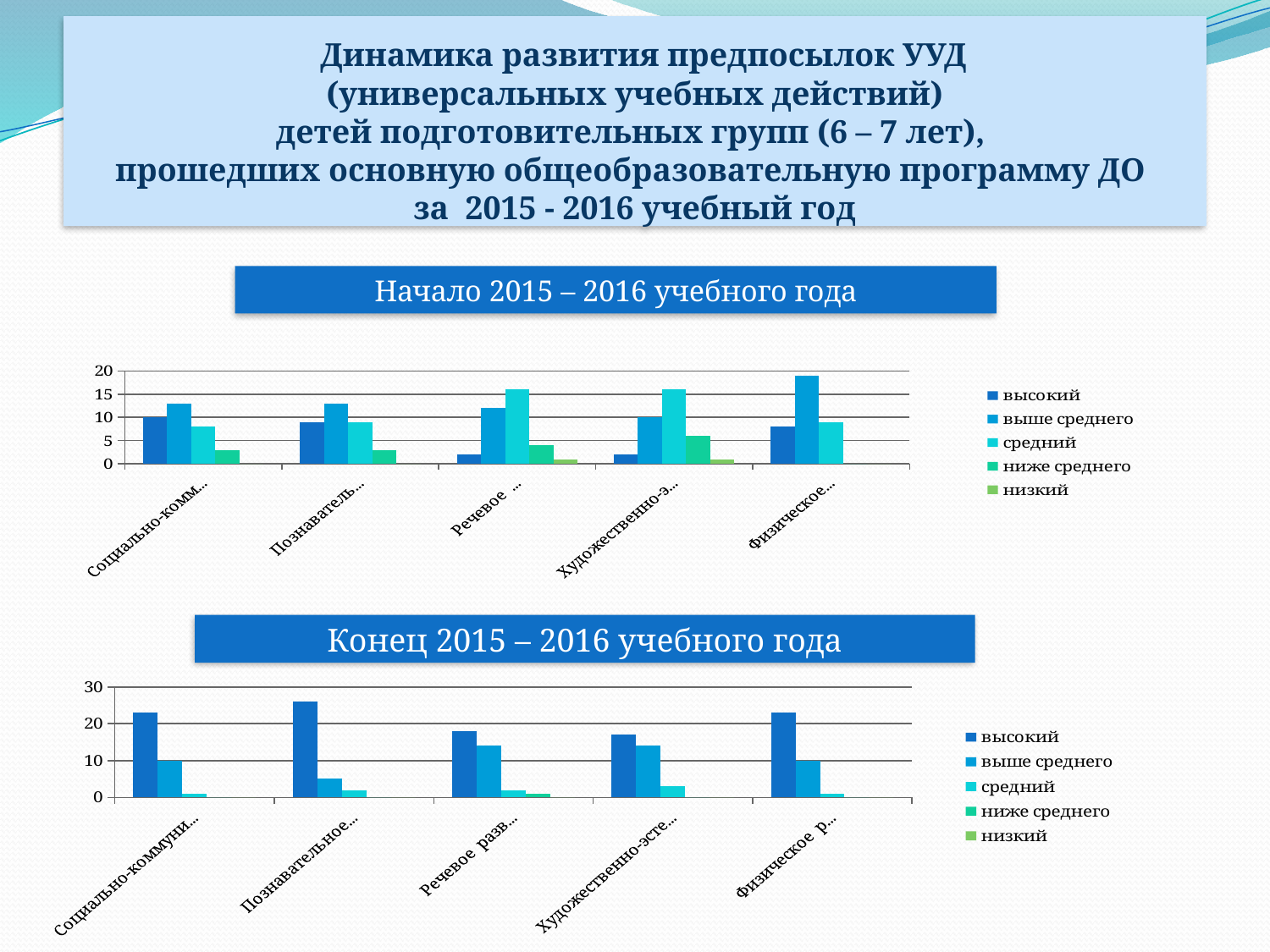
In the chart "Начало 2015 – 2016 учебного года", is the value of "средний" for "Речевое" greater or less than 10? greater In the chart "Начало 2015 – 2016 учебного года", for "Социально-комм...", which is larger: "высокий" or "выше среднего"? выше среднего In the chart "Начало 2015 – 2016 учебного года", which series has the tallest bar for "Физическое"? выше среднего In the chart "Начало 2015 – 2016 учебного года", is the value of "высокий" for "Физическое" greater or less than 15? less In the chart "Начало 2015 – 2016 учебного года", how many series does the legend list? 5 What kind of chart is shown under the heading "Начало 2015 – 2016 учебного года"? bar chart In the chart "Начало 2015 – 2016 учебного года", which series has the shortest bar for "Речевое"? низкий In the chart "Конец 2015 – 2016 учебного года", is the value of "высокий" for "Познавательное" greater or less than 20? greater In the chart "Начало 2015 – 2016 учебного года", how many categories are shown on the x axis? 5 In the chart "Конец 2015 – 2016 учебного года", for "Социально-коммуни...", which is larger: "высокий" or "выше среднего"? высокий In the chart "Конец 2015 – 2016 учебного года", which category has the tallest "высокий" bar? Познавательное